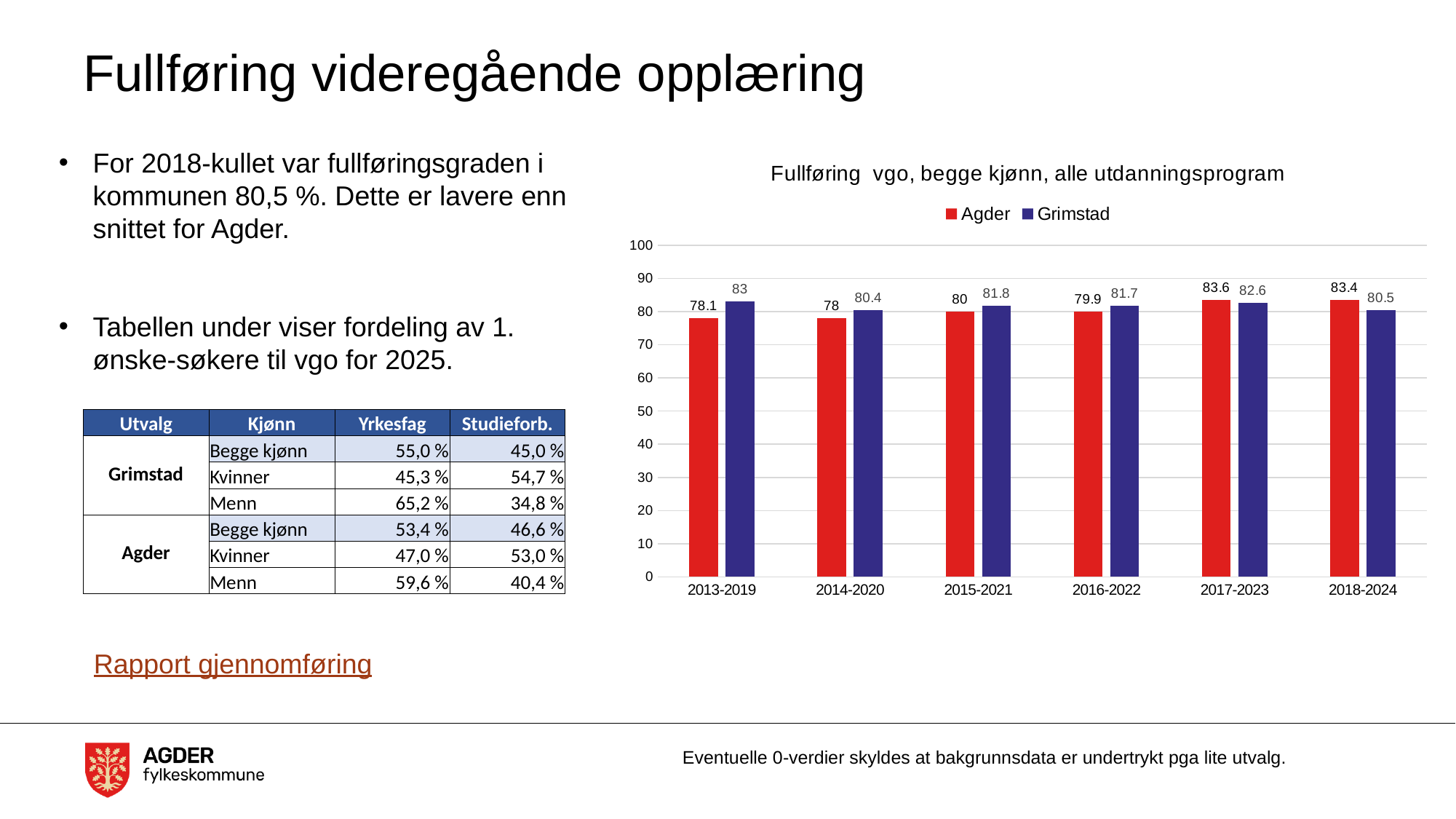
In which period is the Grimstad value lowest? 2014-2020 What is the Grimstad value for 2018-2024? 80.5 What is the difference between the Grimstad and Agder values for 2013-2019? 4.9 What is the Agder value for 2017-2023? 83.6 Which is larger for 2018-2024, Agder or Grimstad? Agder What is the Agder value for 2013-2019? 78.1 In which period is the Agder value highest? 2017-2023 What is the Grimstad value for 2015-2021? 81.8 How many series does the legend list? 2 How many periods are shown on the x axis? 6 What is the title of the chart? Fullføring vgo, begge kjønn, alle utdanningsprogram What kind of chart is shown? Bar chart